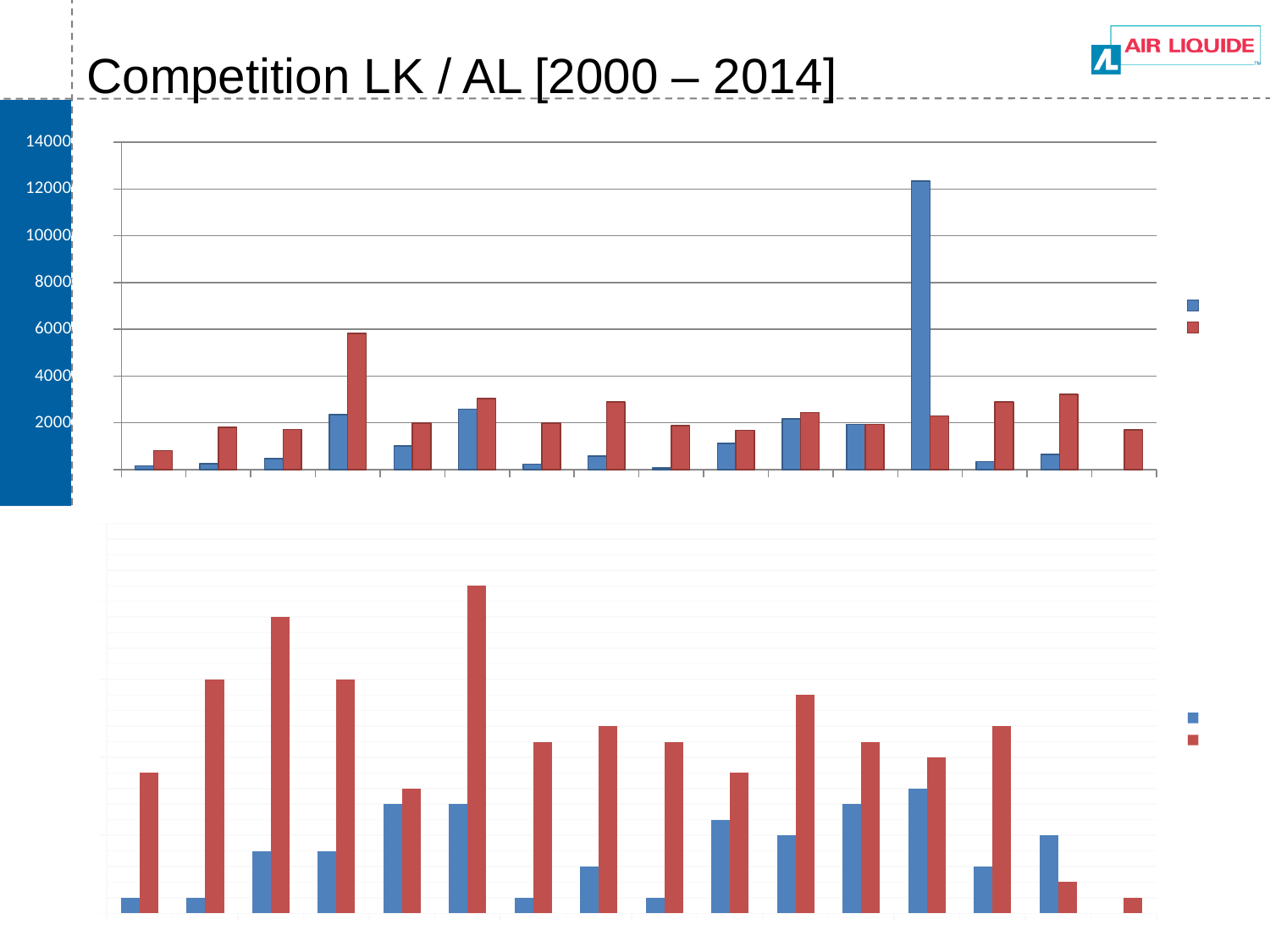
In the top chart, in the fourth group of bars from the left, is the blue bar or the red bar taller? red What is the title of the slide? Competition LK / AL [2000 – 2014] How many series does the legend of the top chart list? 2 In the top chart, is the tallest red bar greater or less than 6000? less In the top chart, is the tallest red bar greater or less than 4000? greater How many series does the legend of the bottom chart list? 2 In the bottom chart, in the second group of bars from the right, is the blue bar or the red bar taller? blue In the top chart, is the tallest blue bar greater or less than 12000? greater In the top chart, which series (blue or red) has the single tallest bar? blue What kind of chart is the bottom chart on the slide? bar chart What kind of chart is the top chart on the slide? bar chart What is the highest value labelled on the vertical axis of the top chart? 14000